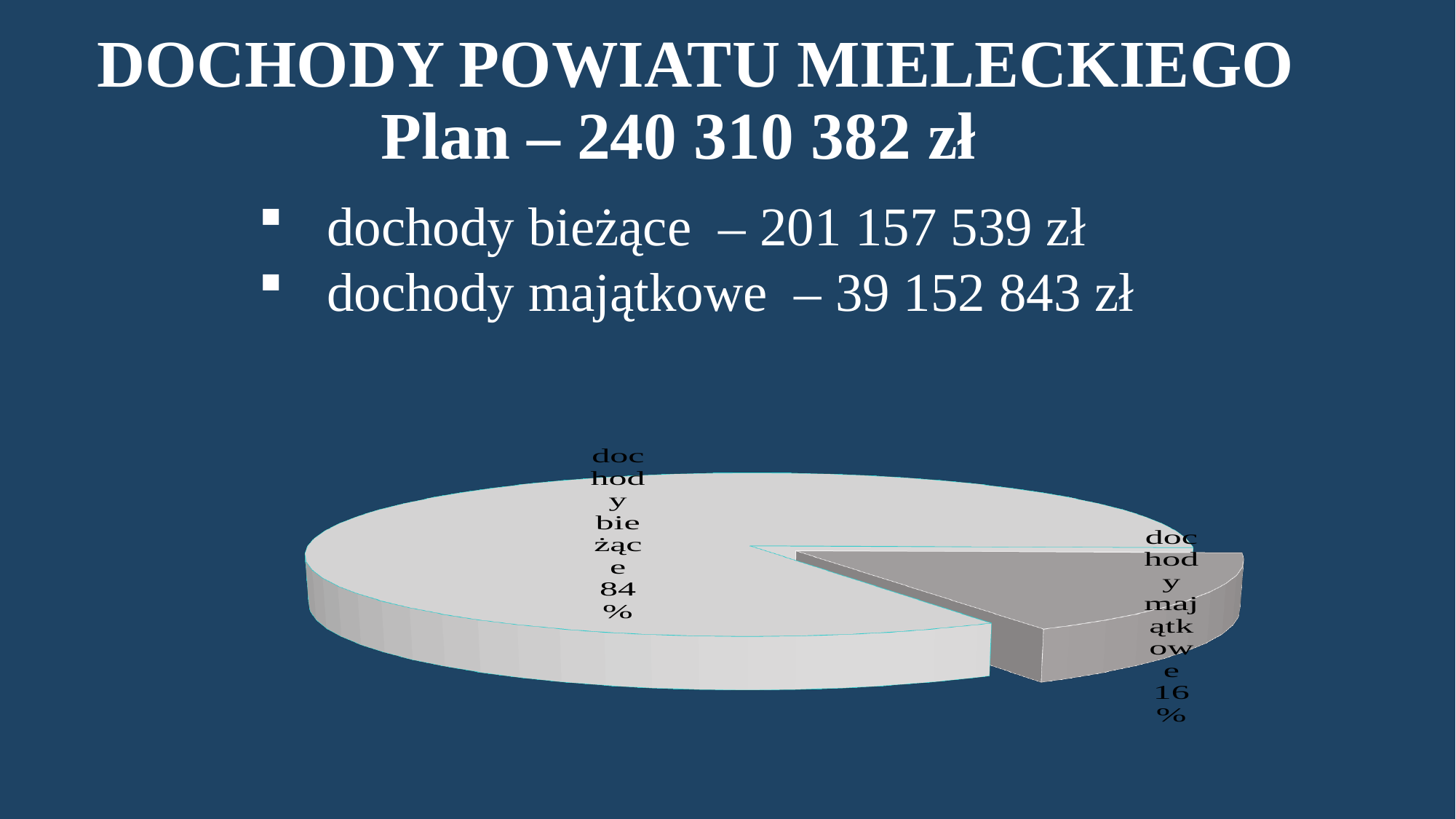
What share of the pie does "dochody bieżące" represent? 84% How many slices does the pie chart have? 2 Which slice of the pie is the smallest? dochody majątkowe Which slice of the pie is pulled out (exploded) from the rest? dochody majątkowe Which slice is larger, "dochody bieżące" or "dochody majątkowe"? dochody bieżące What kind of chart is shown on the slide? pie chart What is the difference in percentage points between the "dochody bieżące" and "dochody majątkowe" slices? 68 What share of the pie does "dochody majątkowe" represent? 16% Is the share for "dochody majątkowe" greater or less than 50%? less Which slice of the pie is the largest? dochody bieżące What is the total planned income (Plan) stated in the slide title? 240 310 382 zł